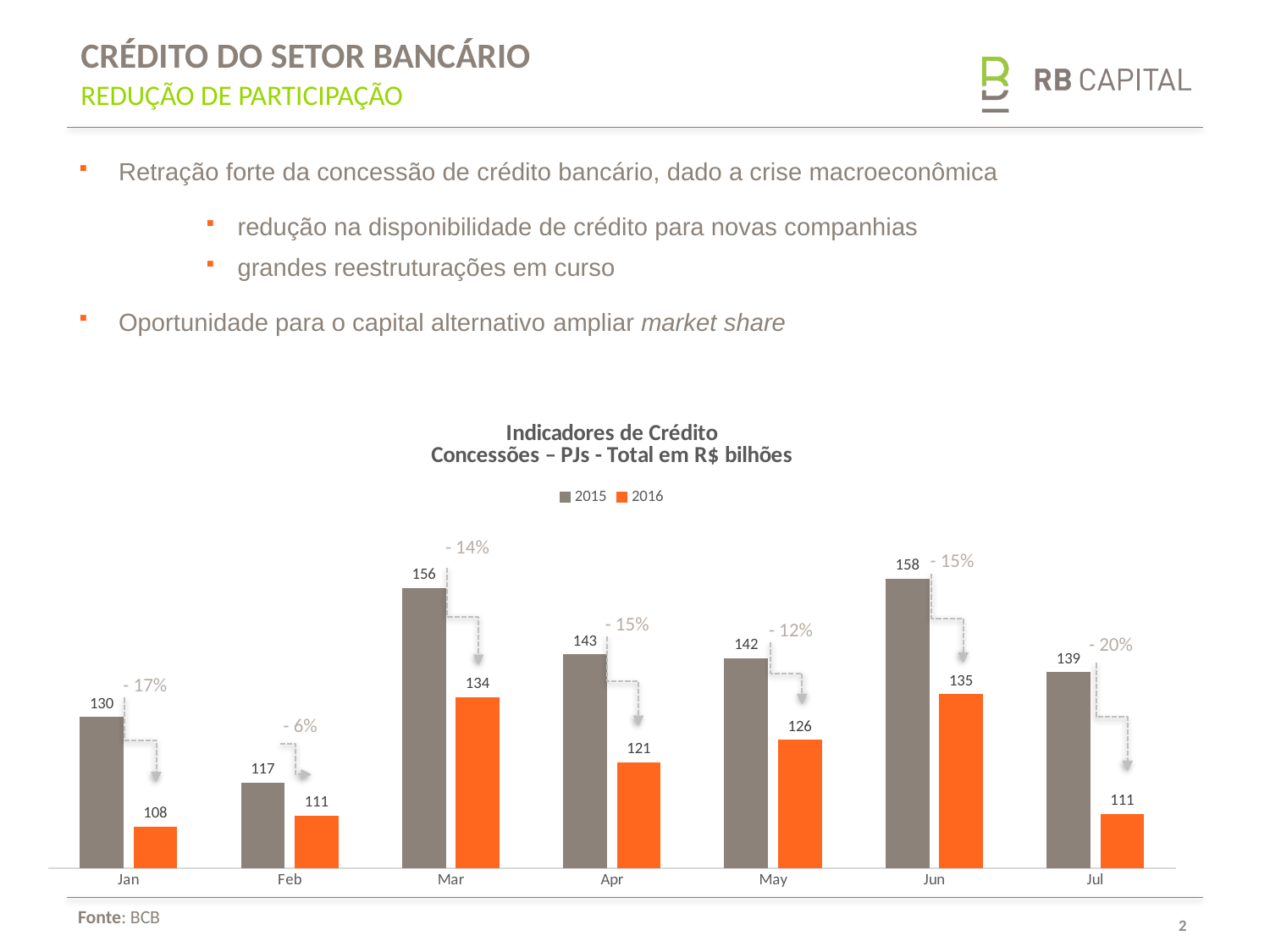
How many months are shown on the x axis? 7 Which month has the lowest 2015 value? Feb What kind of chart is shown on the slide? Bar chart Which month has the lowest 2016 value? Jan How many series does the legend list? 2 Which is larger, the 2016 value for Apr or the 2016 value for Feb? Apr Which month has the highest 2015 value? Jun What is the difference between the 2015 and 2016 values for Jan? 22 What is the 2016 value for Jul? 111 What is the 2016 value for May? 126 What is the 2015 value for Mar? 156 What is the difference between the 2015 and 2016 values for Jun? 23